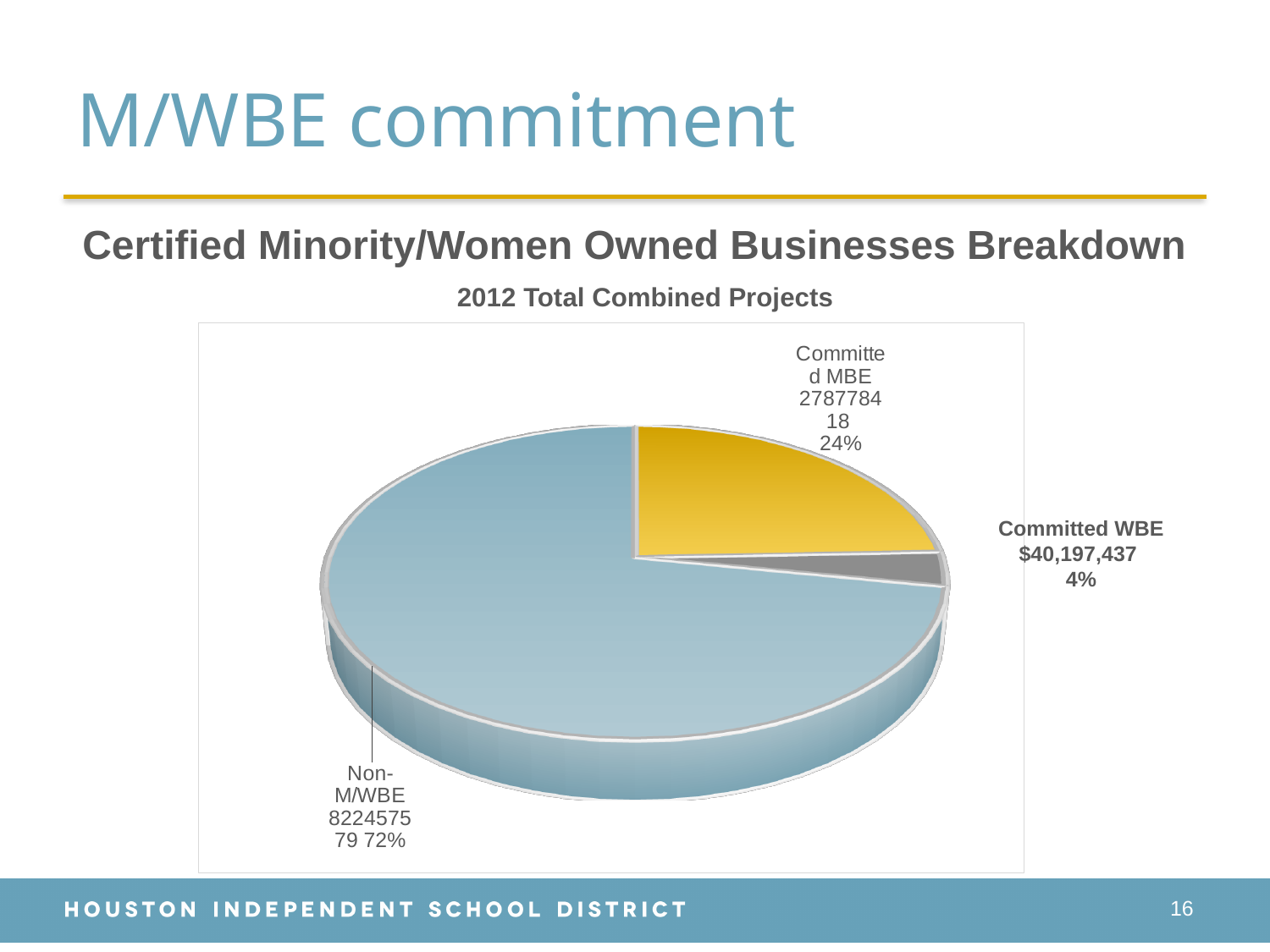
Which is larger, the Committed MBE share or the Committed WBE share? Committed MBE What is the title of the chart? 2012 Total Combined Projects What share of the pie does Committed WBE represent? 4% What is the difference in percentage points between the Non-M/WBE share and the Committed MBE share? 48 What is the dollar value shown for Committed WBE? $40,197,437 Which slice of the pie is the smallest? Committed WBE What type of chart is shown on the slide? pie chart What colour is the Committed MBE slice? yellow What share of the pie does Committed MBE represent? 24% What share of the pie does Non-M/WBE represent? 72% How many slices does the pie chart have? 3 Which slice of the pie is the largest? Non-M/WBE